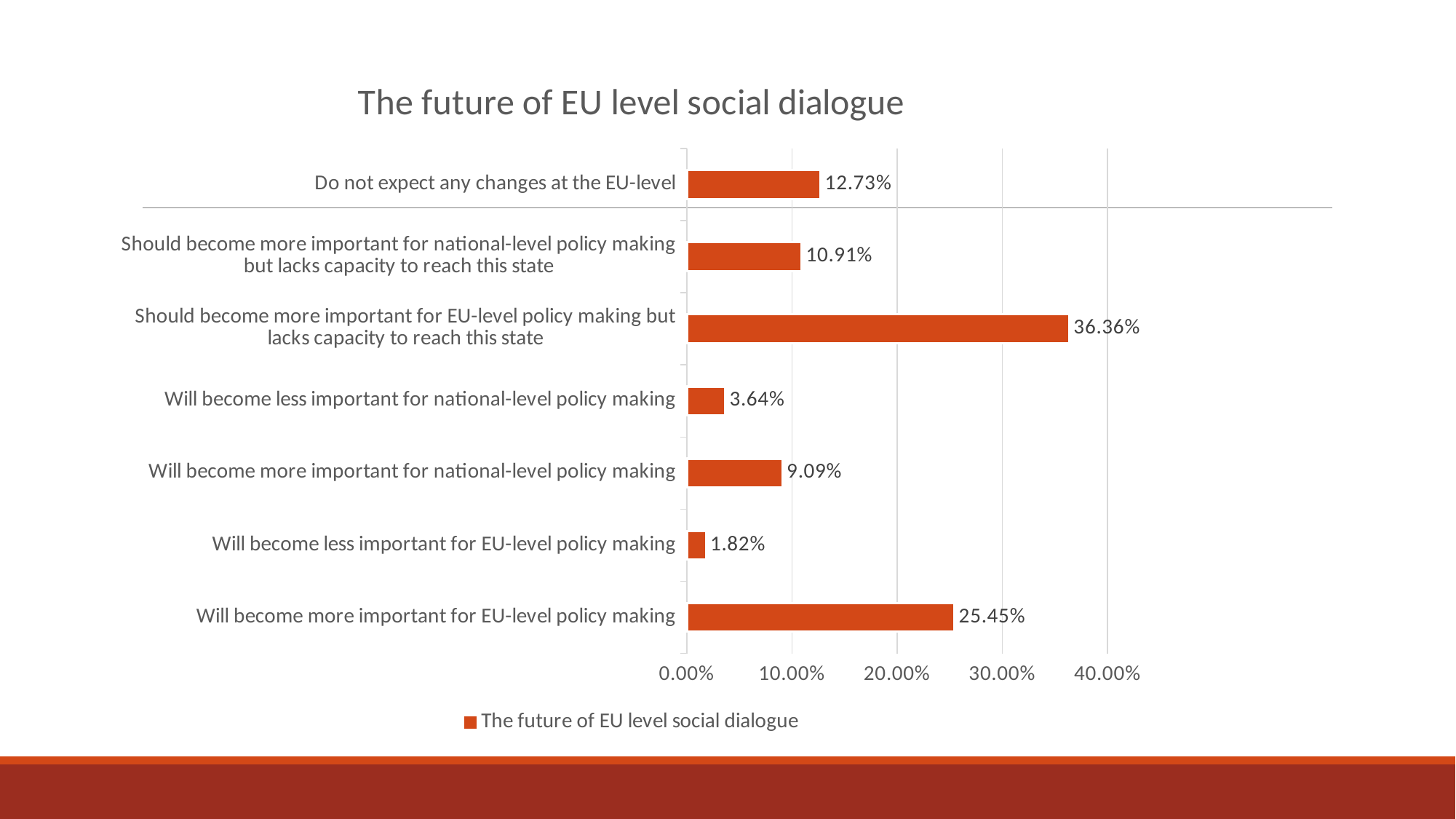
How many series does the legend list? 1 What is the difference between the values for "Should become more important for EU-level policy making but lacks capacity to reach this state" and "Will become more important for EU-level policy making"? 10.91% What is the value for "Will become less important for national-level policy making"? 3.64% How many categories are shown in the chart? 7 What is the value for "Do not expect any changes at the EU-level"? 12.73% Which category has the lowest value? Will become less important for EU-level policy making Is the value for "Will become more important for national-level policy making" greater or less than 10.00%? less Which is larger: the value for "Do not expect any changes at the EU-level" or the value for "Should become more important for national-level policy making but lacks capacity to reach this state"? Do not expect any changes at the EU-level Which category has the highest value? Should become more important for EU-level policy making but lacks capacity to reach this state What is the title of the chart? The future of EU level social dialogue What is the value for "Will become more important for EU-level policy making"? 25.45% What kind of chart is shown on the slide? Bar chart